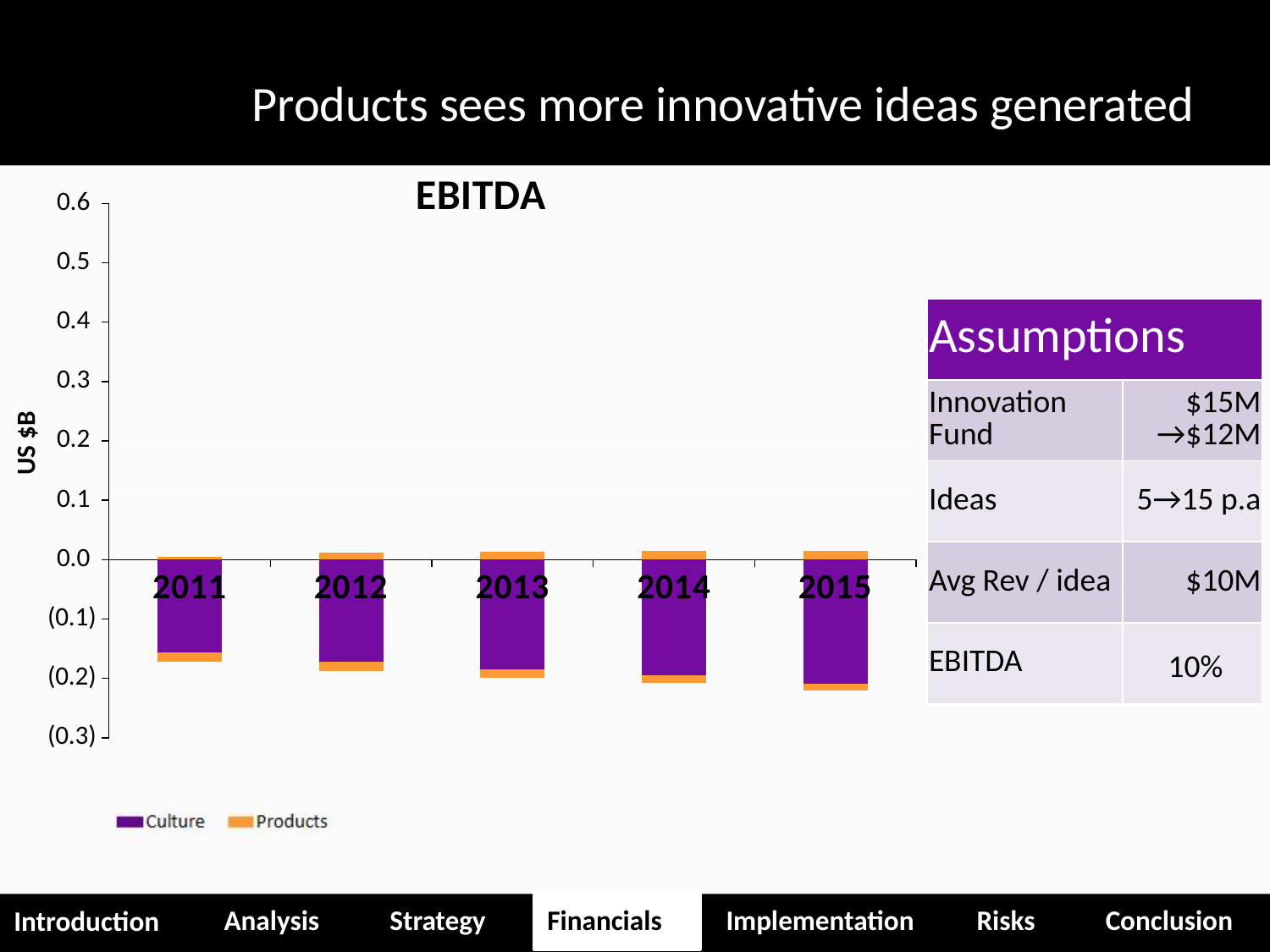
How many years are shown on the x axis of the chart? 5 What kind of chart is shown on the slide? Stacked bar chart How many series does the chart's legend list? 2 Is the Culture value for 2015 greater or less than (0.3)? greater What is the label on the vertical axis of the chart? US $B Which year has the highest (least negative) Culture value? 2011 Which series is shown in purple in the chart? Culture Is the Culture value for 2011 greater or less than 0.0? less Is the Culture value for 2011 greater or less than (0.1)? less Which year has the lowest (most negative) Culture value? 2015 What is the title of the chart? EBITDA Do the Culture values become more negative or less negative from 2011 to 2015? More negative